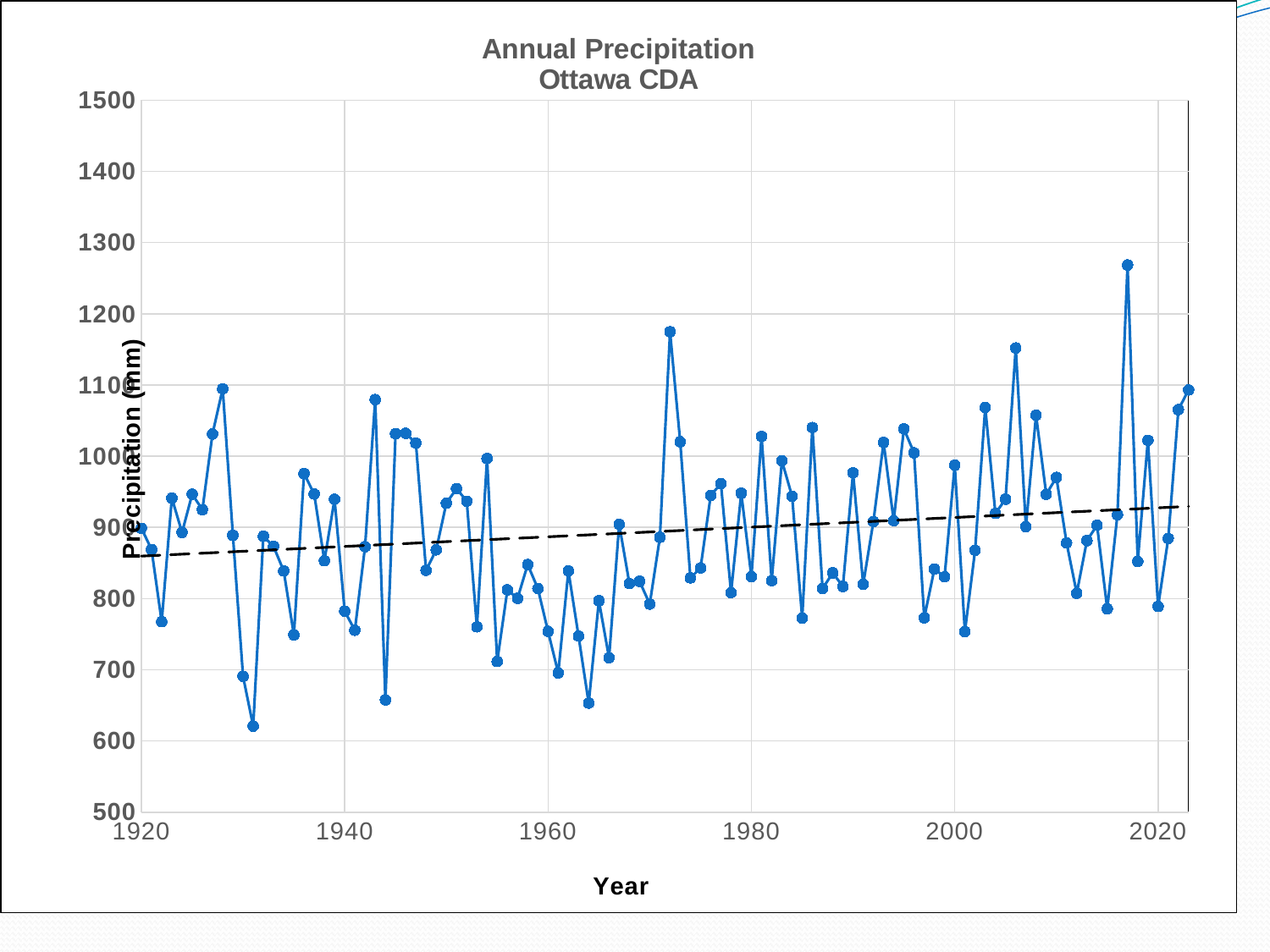
What is the title of the chart? Annual Precipitation Ottawa CDA In which year does the annual precipitation reach its lowest value? 1931 Is the value for 1972 greater or less than 1100? greater Is the value for 1964 greater or less than 700? less Which year has the higher precipitation, 2017 or 1972? 2017 In which year does the annual precipitation reach its highest value? 2017 Does the dashed trend line rise or fall from 1920 to 2020? rise Is the value for 1931 greater or less than 700? less What is the label of the y axis? Precipitation (mm) What kind of chart is shown on the slide? line chart